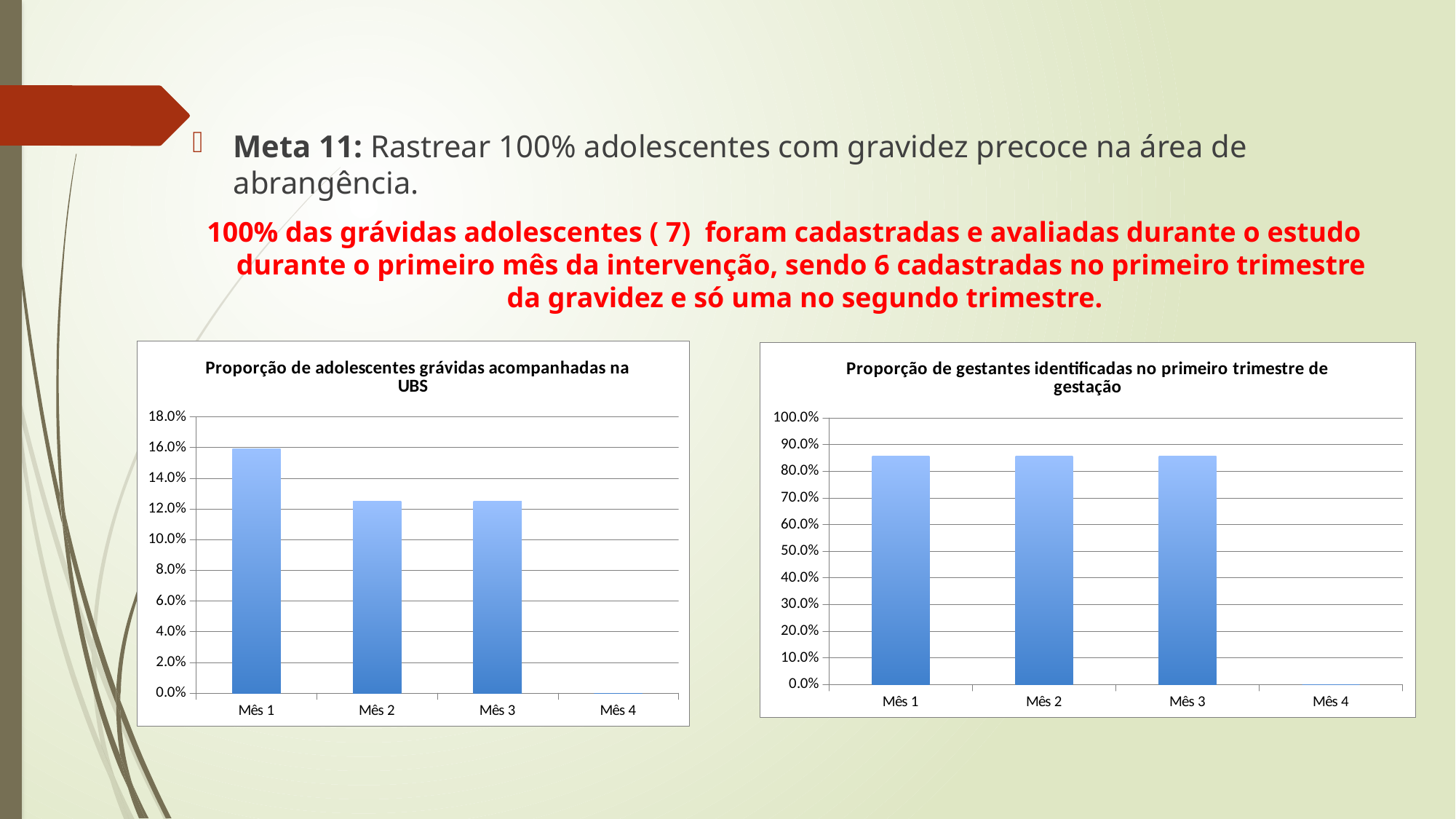
What kind of chart is the right chart, 'Proporção de gestantes identificadas no primeiro trimestre de gestação'? bar chart What kind of chart is the left chart, 'Proporção de adolescentes grávidas acompanhadas na UBS'? bar chart In the right chart, 'Proporção de gestantes identificadas no primeiro trimestre de gestação', is the value for Mês 1 greater or less than 80.0%? greater In the left chart, 'Proporção de adolescentes grávidas acompanhadas na UBS', which is larger, the value for Mês 1 or the value for Mês 3? Mês 1 In the left chart, 'Proporção de adolescentes grávidas acompanhadas na UBS', which month has the highest value? Mês 1 In the left chart, 'Proporção de adolescentes grávidas acompanhadas na UBS', is the value for Mês 2 greater or less than 14.0%? less In the right chart, 'Proporção de gestantes identificadas no primeiro trimestre de gestação', which month has the lowest value? Mês 4 In the left chart, 'Proporção de adolescentes grávidas acompanhadas na UBS', is the value for Mês 1 greater or less than 14.0%? greater In the left chart, 'Proporção de adolescentes grávidas acompanhadas na UBS', which month has the lowest value? Mês 4 In the left chart, 'Proporção de adolescentes grávidas acompanhadas na UBS', do the values generally rise or fall from Mês 1 to Mês 4? fall How many categories are shown on the x axis of the left chart, 'Proporção de adolescentes grávidas acompanhadas na UBS'? 4